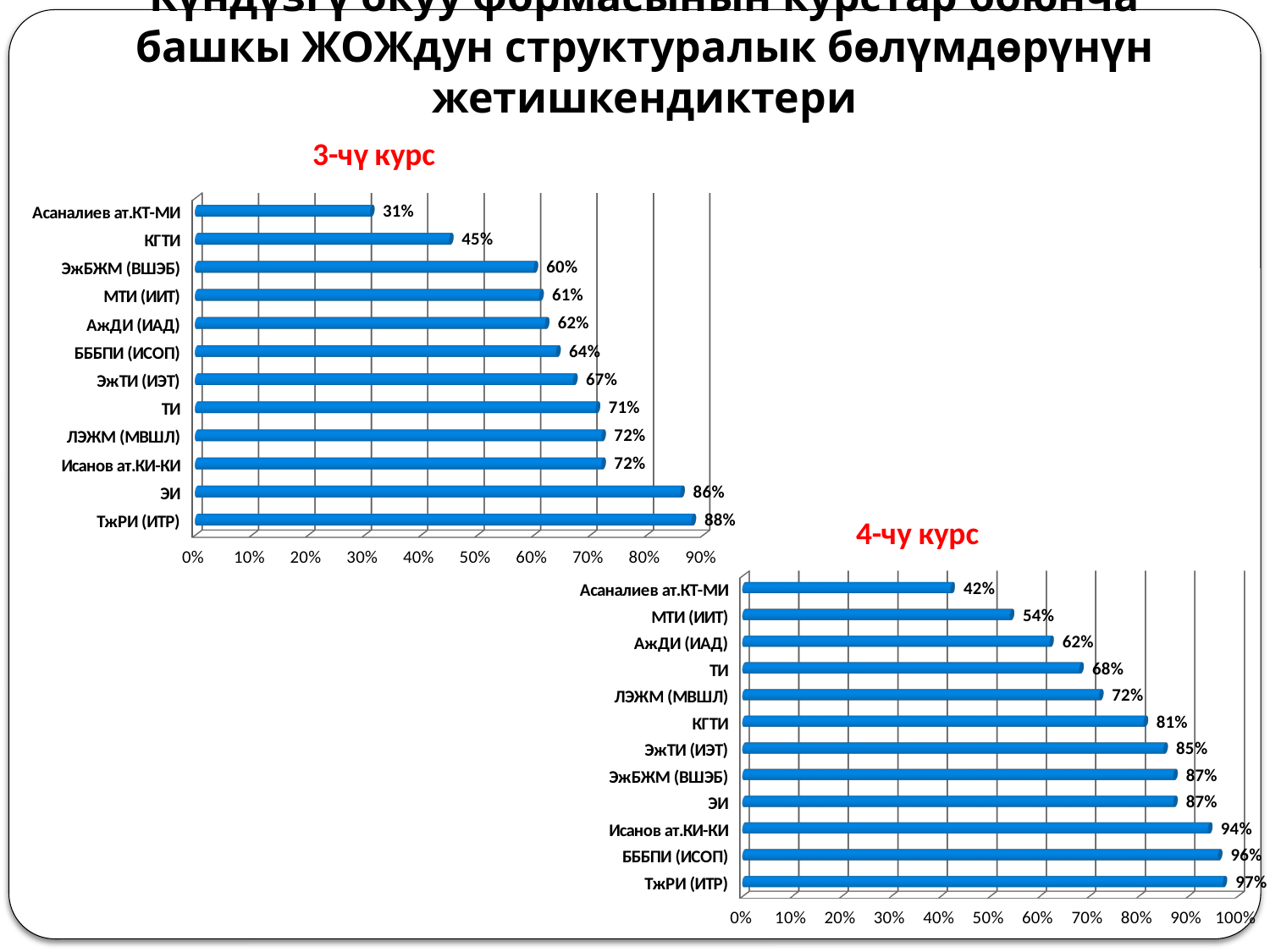
In the "4-чу курс" chart, what is the difference between the values for ТжРИ (ИТР) and МТИ (ИИТ)? 43% In the "3-чү курс" chart, which category has the highest value? ТжРИ (ИТР) In the "4-чу курс" chart, is the value for ЭжТИ (ИЭТ) greater or less than 80%? greater What is the title of the chart on the lower right of the slide? 4-чу курс In the "3-чү курс" chart, what is the difference between the values for ЭИ and ТИ? 15% In the "3-чү курс" chart, how many categories are shown? 12 In the "4-чу курс" chart, what is the value for Исанов ат.КИ-КИ? 94% What type of chart is the "4-чу курс" chart? Bar chart In the "3-чү курс" chart, which category has the lowest value? Асаналиев ат.КТ-МИ In the "4-чу курс" chart, which category has the lowest value? Асаналиев ат.КТ-МИ In the "3-чү курс" chart, what is the value for КГТИ? 45% In the "4-чу курс" chart, which is larger, the value for КГТИ or the value for ТИ? КГТИ